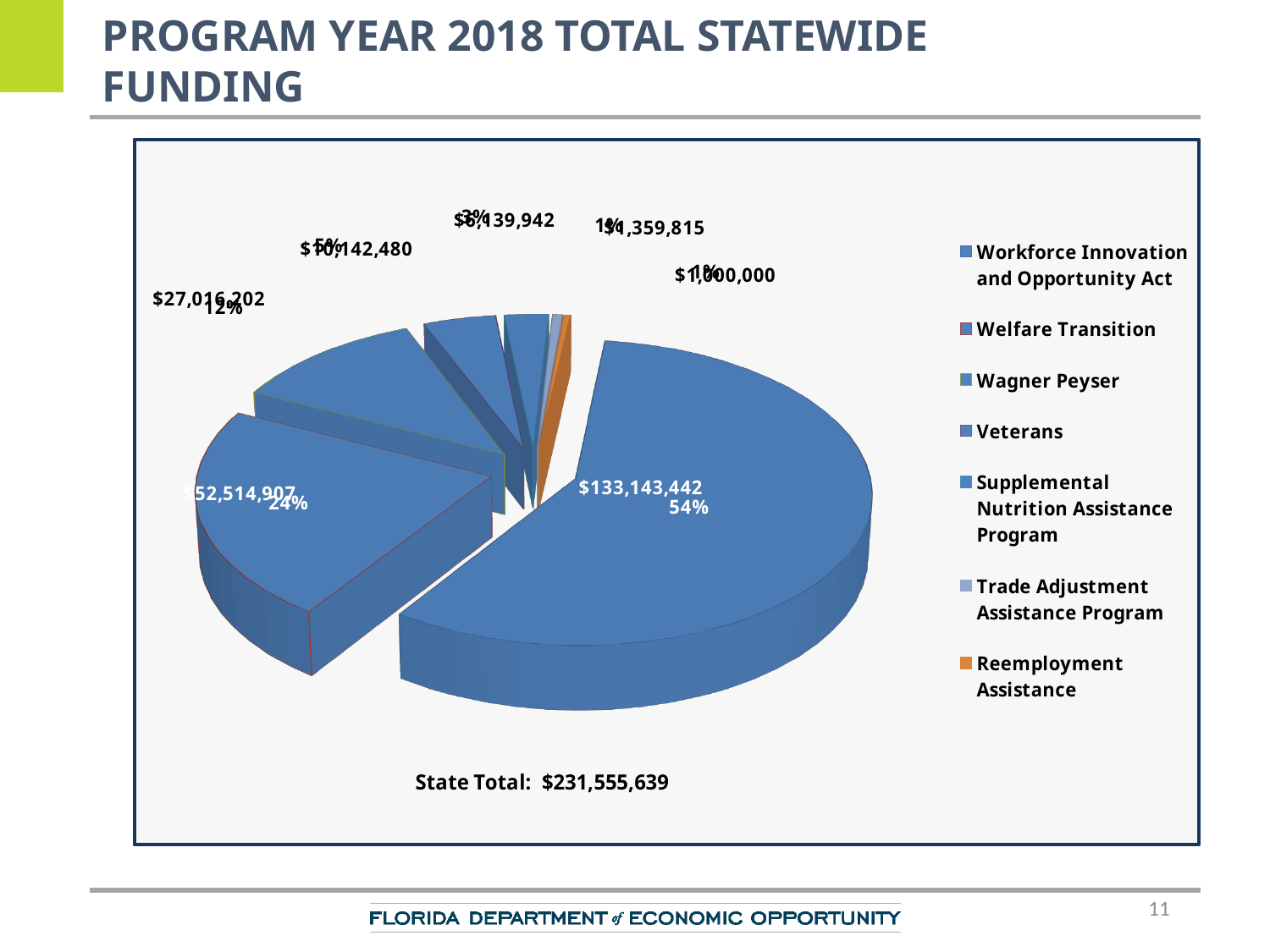
Which legend entry is shown in orange? Reemployment Assistance What is the State Total shown below the pie chart? $231,555,639 Which is larger, the slice labeled $133,143,442 or the slice labeled $52,514,907? $133,143,442 What share of the pie does the slice labeled $52,514,907 represent? 24% What is the dollar value labeled on the orange slice? $1,000,000 Which program accounts for the largest share of statewide funding? Workforce Innovation and Opportunity Act What share of the pie does the slice labeled $27,016,202 represent? 12% How many programs does the legend list? 7 What kind of chart is shown on the slide? pie chart What share of the pie does the largest slice represent? 54% What is the dollar value of the largest slice of the pie? $133,143,442 What is the difference in dollars between the slice labeled $133,143,442 and the slice labeled $52,514,907? $80,628,535